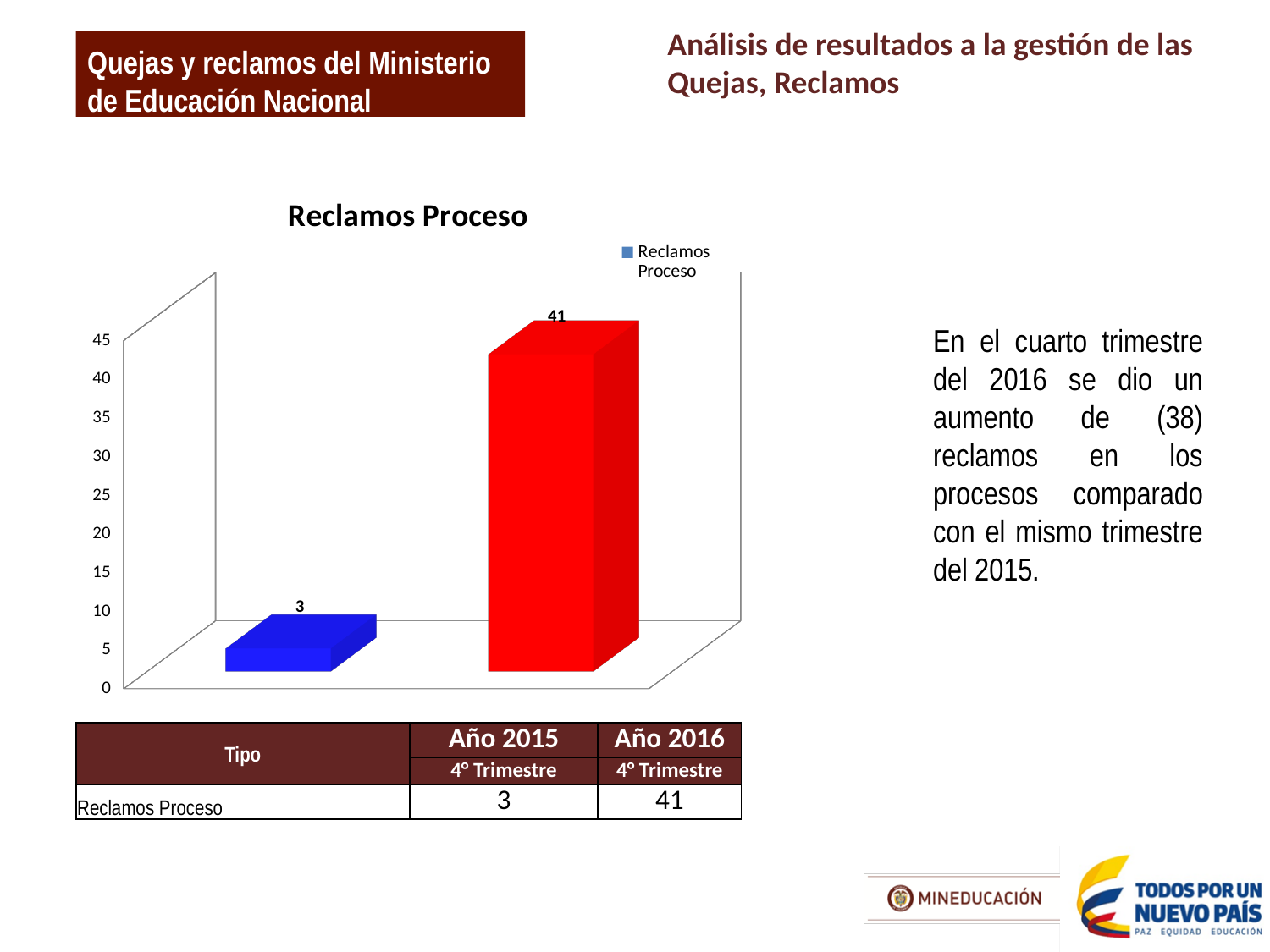
How many bars are plotted in the 'Reclamos Proceso' chart? 2 What is the legend entry shown in the 'Reclamos Proceso' chart? Reclamos Proceso According to the table, how many Reclamos Proceso were there in the 4° Trimestre of Año 2016? 41 What is the value shown on the red bar in the 'Reclamos Proceso' chart? 41 Is the value of the red bar in the 'Reclamos Proceso' chart greater or less than 40? greater What is the value shown on the blue bar in the 'Reclamos Proceso' chart? 3 What type of chart is shown under the title 'Reclamos Proceso'? bar chart How many series does the legend of the 'Reclamos Proceso' chart list? 1 Which bar in the 'Reclamos Proceso' chart is taller, the blue one or the red one? the red one What is the highest value shown on the vertical axis of the 'Reclamos Proceso' chart? 45 What is the difference between the two values plotted in the 'Reclamos Proceso' chart? 38 According to the table, how many Reclamos Proceso were there in the 4° Trimestre of Año 2015? 3